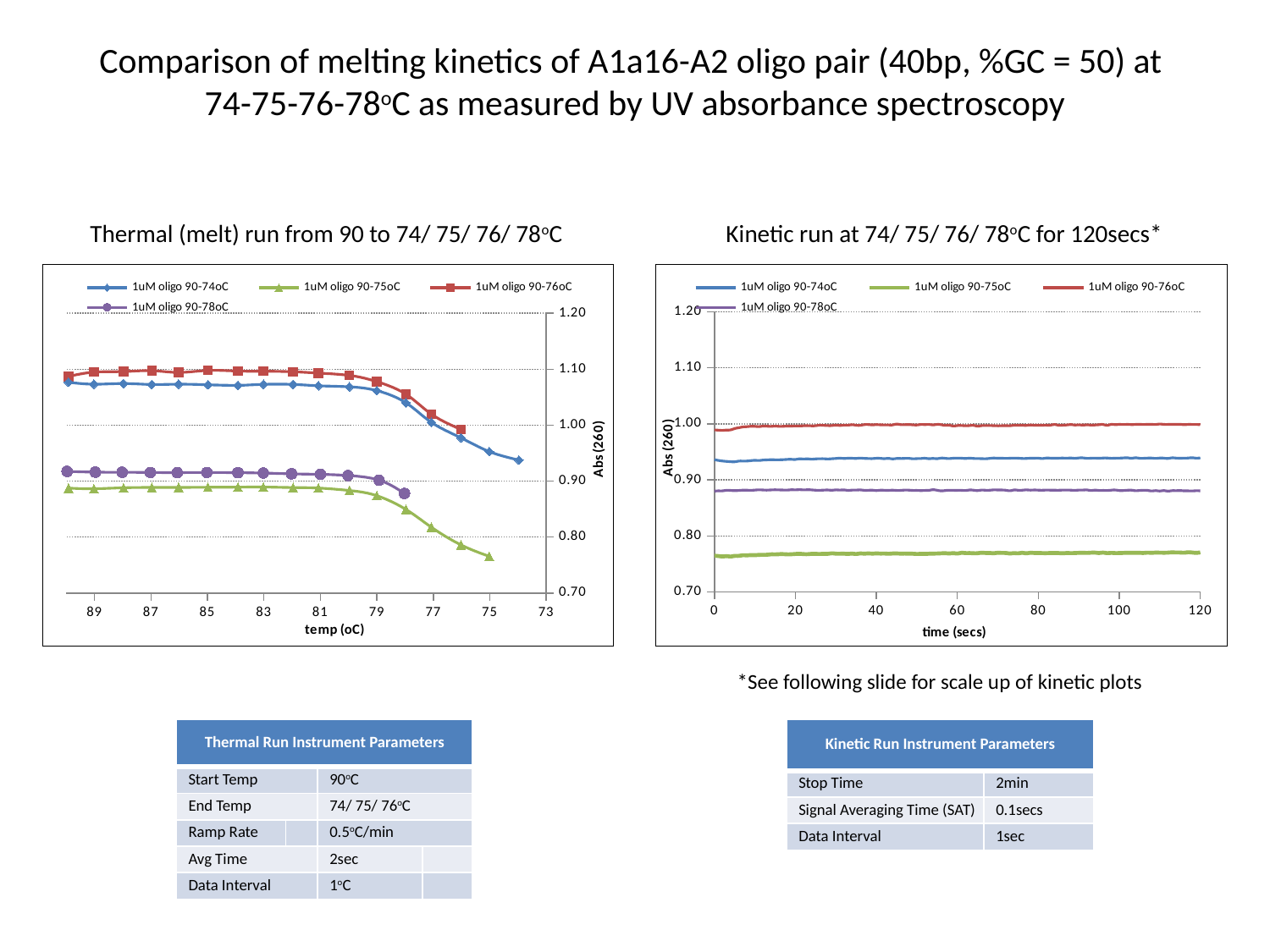
What kind of chart is the 'Thermal (melt) run from 90 to 74/ 75/ 76/ 78oC' chart on the left? line chart In the right 'Kinetic run' chart, is the value for 1uM oligo 90-75oC at 60 secs greater or less than 0.80? less How many series does the legend of the 'Kinetic run at 74/ 75/ 76/ 78oC for 120secs' chart on the right list? 4 In the left 'Thermal (melt) run' chart, is the value for 1uM oligo 90-75oC at 75 greater or less than 0.80? less In the left 'Thermal (melt) run' chart, which series has the higher value at 89: 1uM oligo 90-76oC or 1uM oligo 90-75oC? 1uM oligo 90-76oC In the left 'Thermal (melt) run' chart, is the value for 1uM oligo 90-76oC at 89 greater or less than 1.00? greater How many series does the legend of the left 'Thermal (melt) run' chart list? 4 What is the x-axis title of the right 'Kinetic run' chart? time (secs) In the left 'Thermal (melt) run' chart, does the 1uM oligo 90-75oC series rise or fall as the temperature goes from 89 toward 75 along the x axis? fall In the right 'Kinetic run' chart, which series is plotted lowest across the 120 secs? 1uM oligo 90-75oC In the right 'Kinetic run' chart, which series is plotted highest across the 120 secs? 1uM oligo 90-76oC